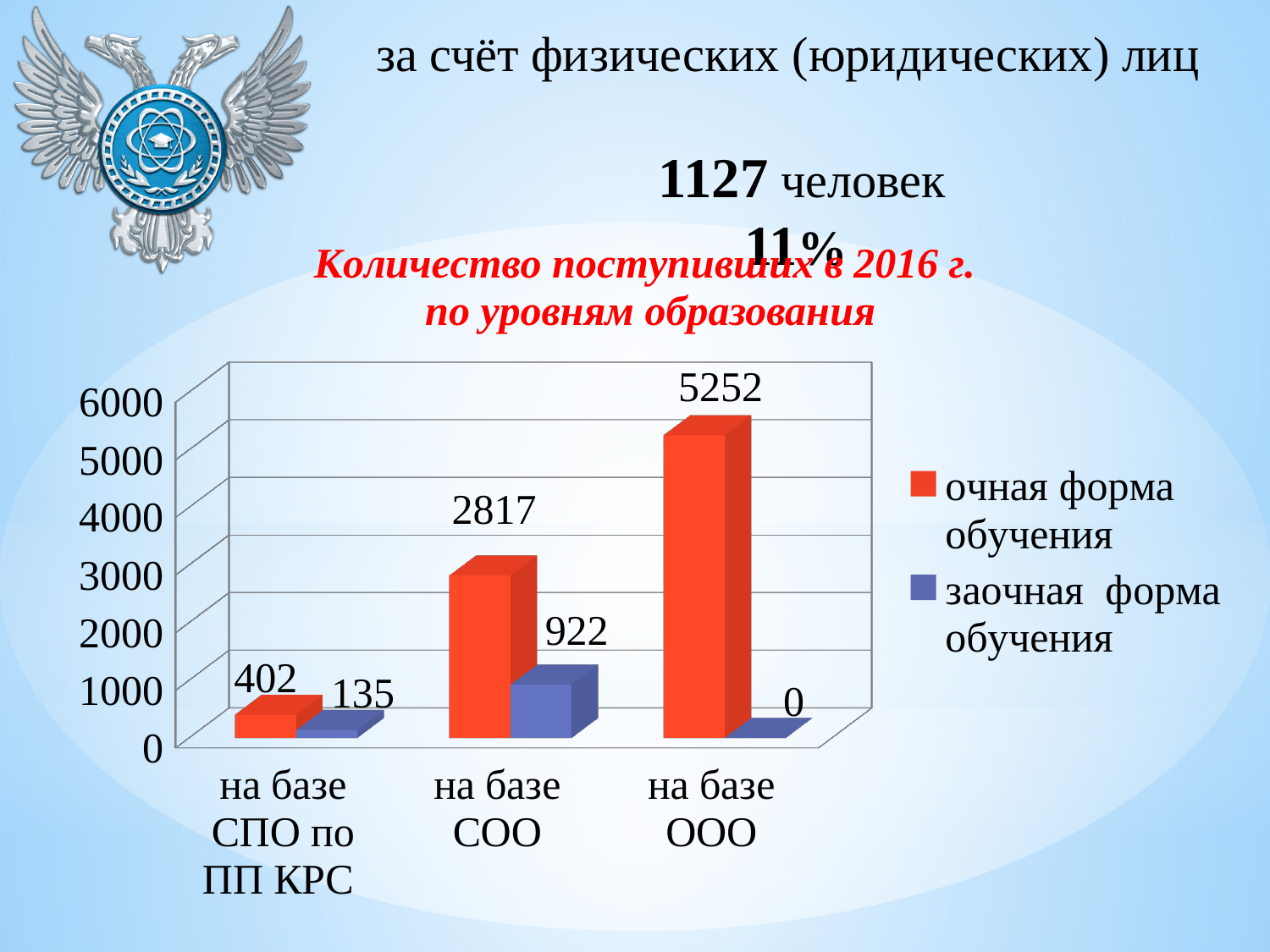
What is the value for очная форма обучения in the category на базе СПО по ПП КРС? 402 What is the difference between очная форма обучения and заочная форма обучения in the category на базе СОО? 1895 What is the value for заочная форма обучения in the category на базе СОО? 922 Which category has the lowest value for заочная форма обучения? на базе ООО Which is larger: очная форма обучения for на базе СОО or очная форма обучения for на базе СПО по ПП КРС? на базе СОО What is the value for очная форма обучения in the category на базе ООО? 5252 What is the value for заочная форма обучения in the category на базе ООО? 0 What is the title of the chart? Количество поступивших в 2016 г. по уровням образования Which category has the highest value for очная форма обучения? на базе ООО What kind of chart is shown on the slide? bar chart How many series does the legend list? 2 How many categories are shown on the x axis? 3